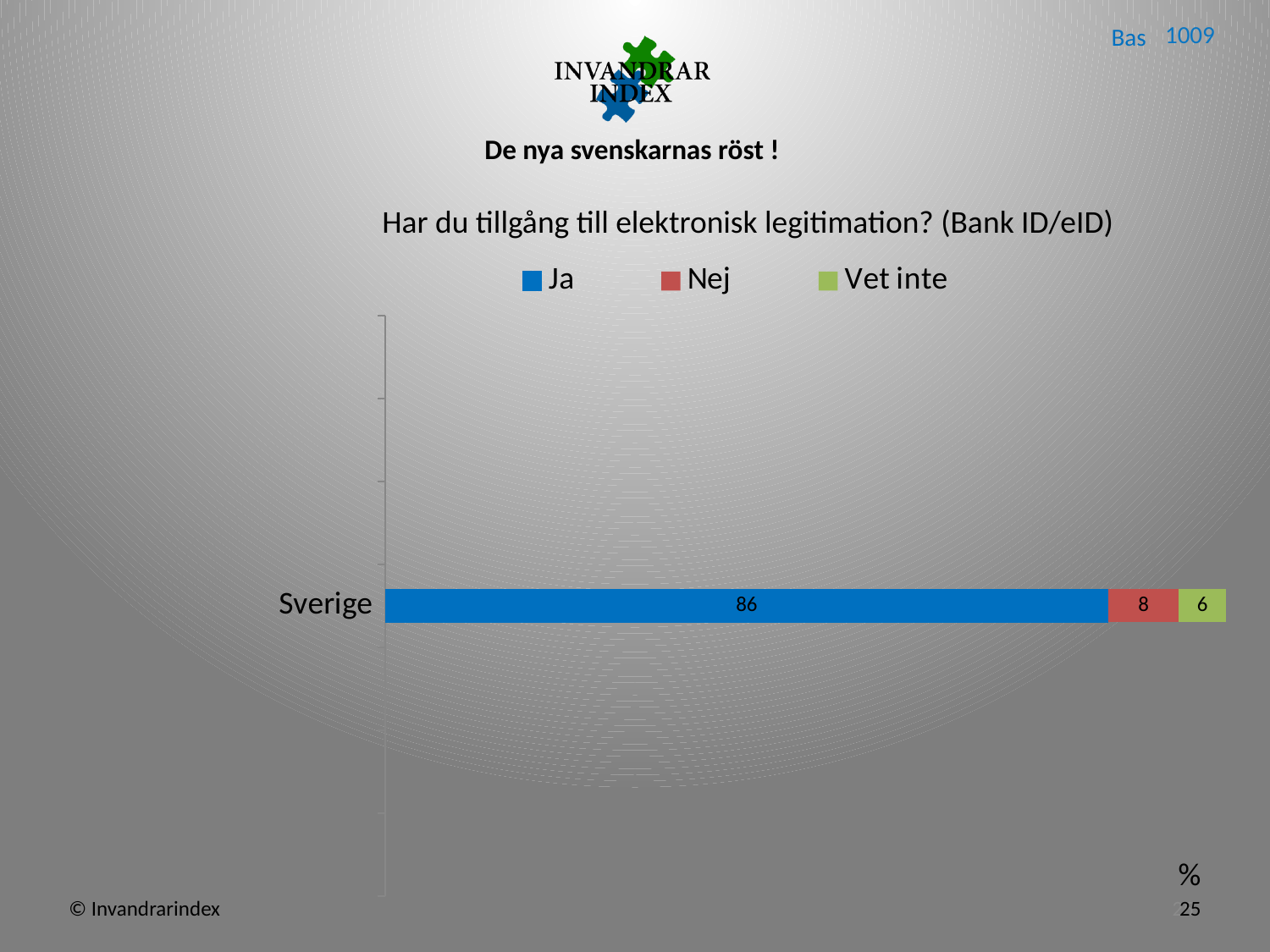
What is the value for "Ja" for Sverige? 86 What is the difference between the "Ja" and "Nej" values for Sverige? 78 What is the total of the stacked bar for Sverige? 100 What is the value for "Nej" for Sverige? 8 How many categories are shown on the chart? 1 What kind of chart is shown on the slide? Stacked bar chart Which series has the lowest value for Sverige? Vet inte Which is larger for Sverige, "Nej" or "Vet inte"? Nej What is the difference between the "Nej" and "Vet inte" values for Sverige? 2 How many series does the legend list? 3 Which series has the highest value for Sverige? Ja What is the value for "Vet inte" for Sverige? 6